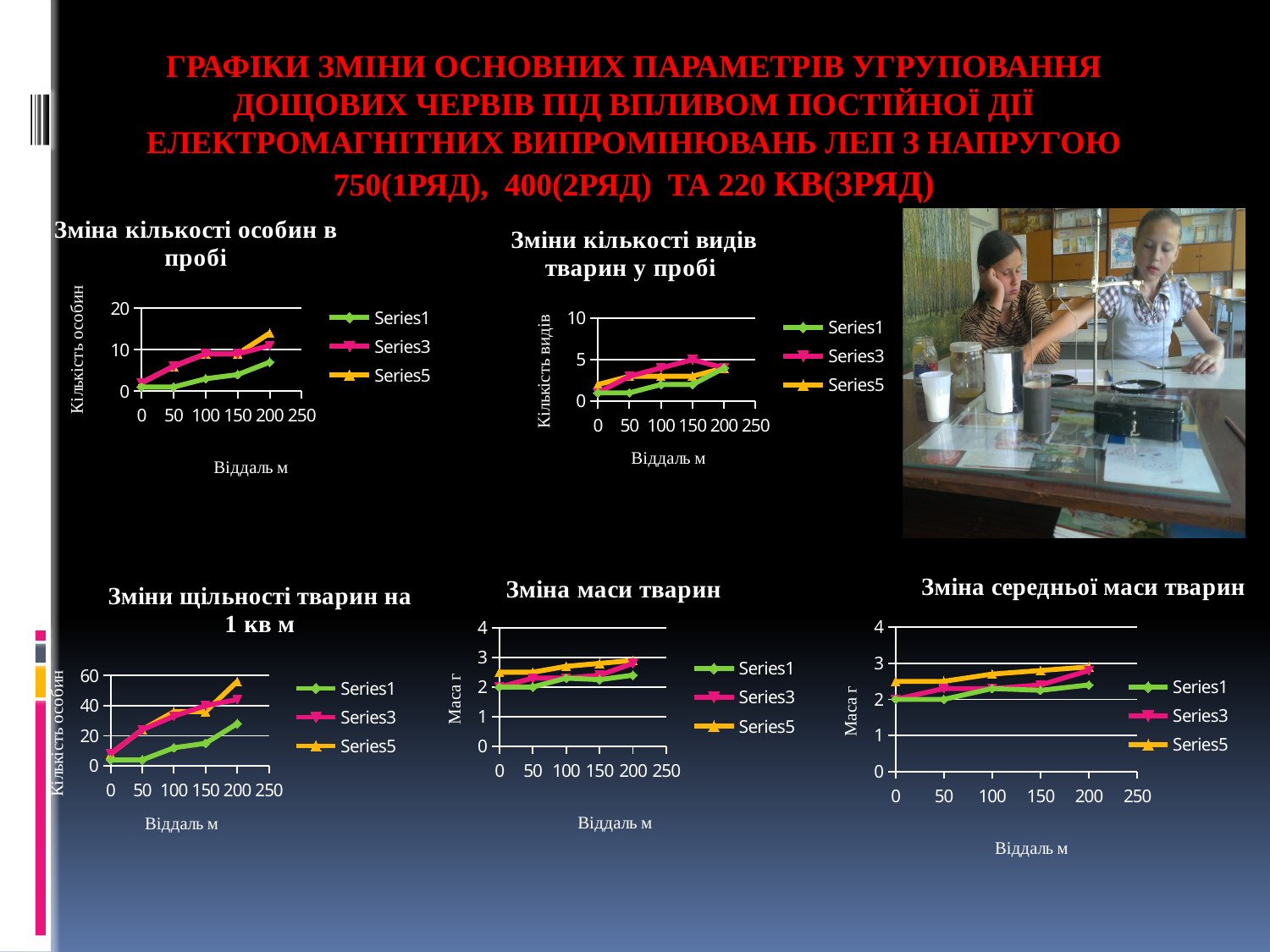
In "Зміни кількості видів тварин у пробі", is the value of Series1 at distance 0 greater or less than 5? less What kind of chart is "Зміна кількості особин в пробі"? line chart In "Зміни щільності тварин на 1 кв м", which is larger at distance 200: Series1 or Series3? Series3 How many series does the legend of "Зміна кількості особин в пробі" list? 3 In "Зміна кількості особин в пробі", which series has the highest value at distance 200? Series5 In "Зміна кількості особин в пробі", does Series1 rise or fall as distance increases from 0 to 200? rise In "Зміни щільності тварин на 1 кв м", is the value of Series5 at distance 200 greater or less than 40? greater In "Зміна кількості особин в пробі", is the value of Series1 at distance 200 greater or less than 10? less In "Зміни кількості видів тварин у пробі", which series has the lowest value at distance 50? Series1 What is the y-axis label of the chart "Зміна середньої маси тварин"? Маса г How many data points does each series have in "Зміни щільності тварин на 1 кв м"? 5